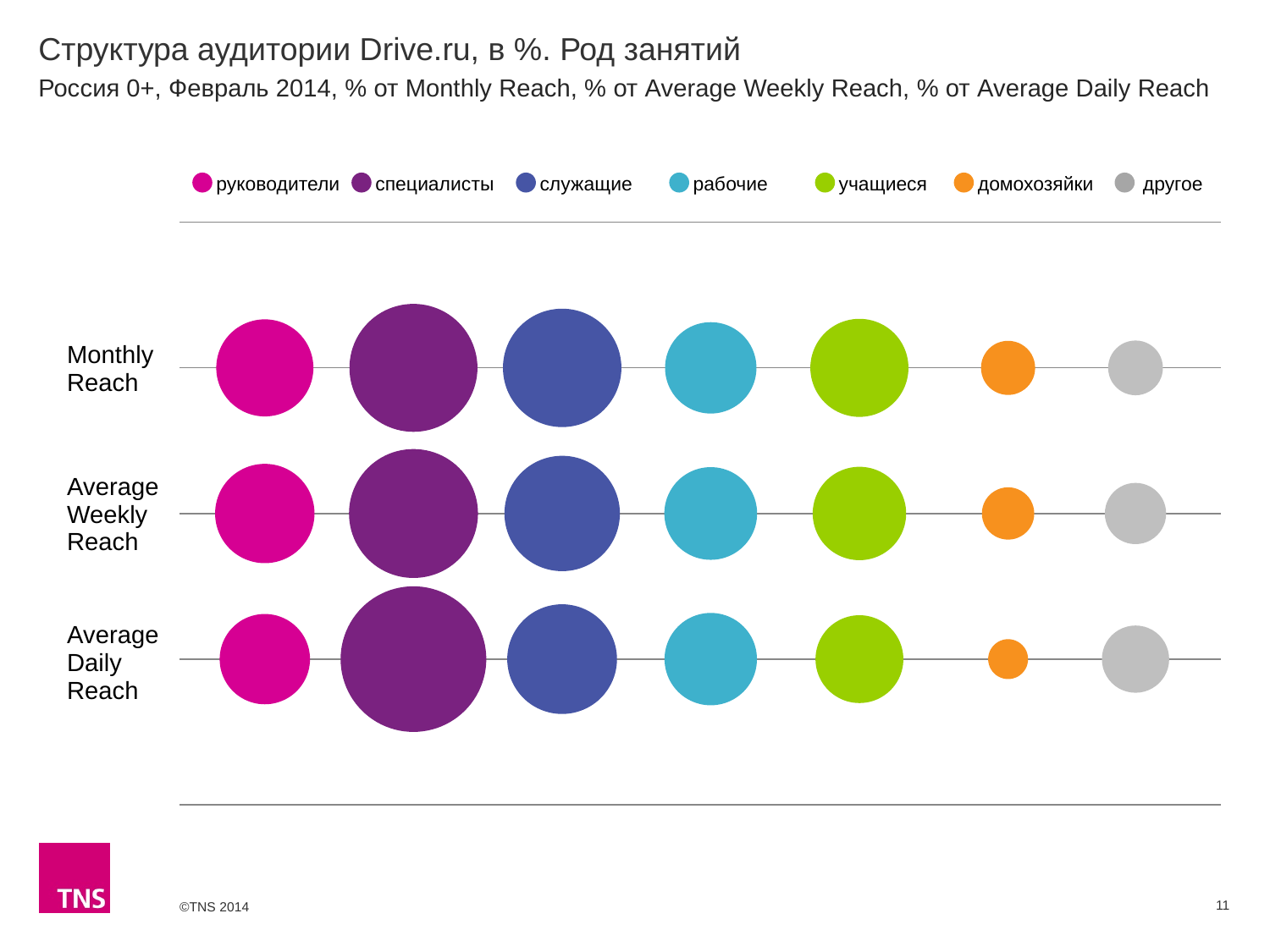
What kind of chart is shown on the slide? bubble chart Which occupation group has the largest bubble in the Monthly Reach row? специалисты Which occupation group has the smallest bubble in the Average Daily Reach row? домохозяйки How many reach rows (categories) are plotted on the chart? 3 In the Monthly Reach row, which bubble is larger: учащиеся or другое? учащиеся What is the title of the chart on the slide? Структура аудитории Drive.ru, в %. Род занятий Which occupation group has the largest bubble in the Average Daily Reach row? специалисты How many occupation groups does the legend list? 7 In the Average Weekly Reach row, which bubble is larger: специалисты or домохозяйки? специалисты Which occupation group is listed first in the legend? руководители Which occupation group has the smallest bubble in the Monthly Reach row? домохозяйки What colour represents the group 'рабочие' in the legend? light blue